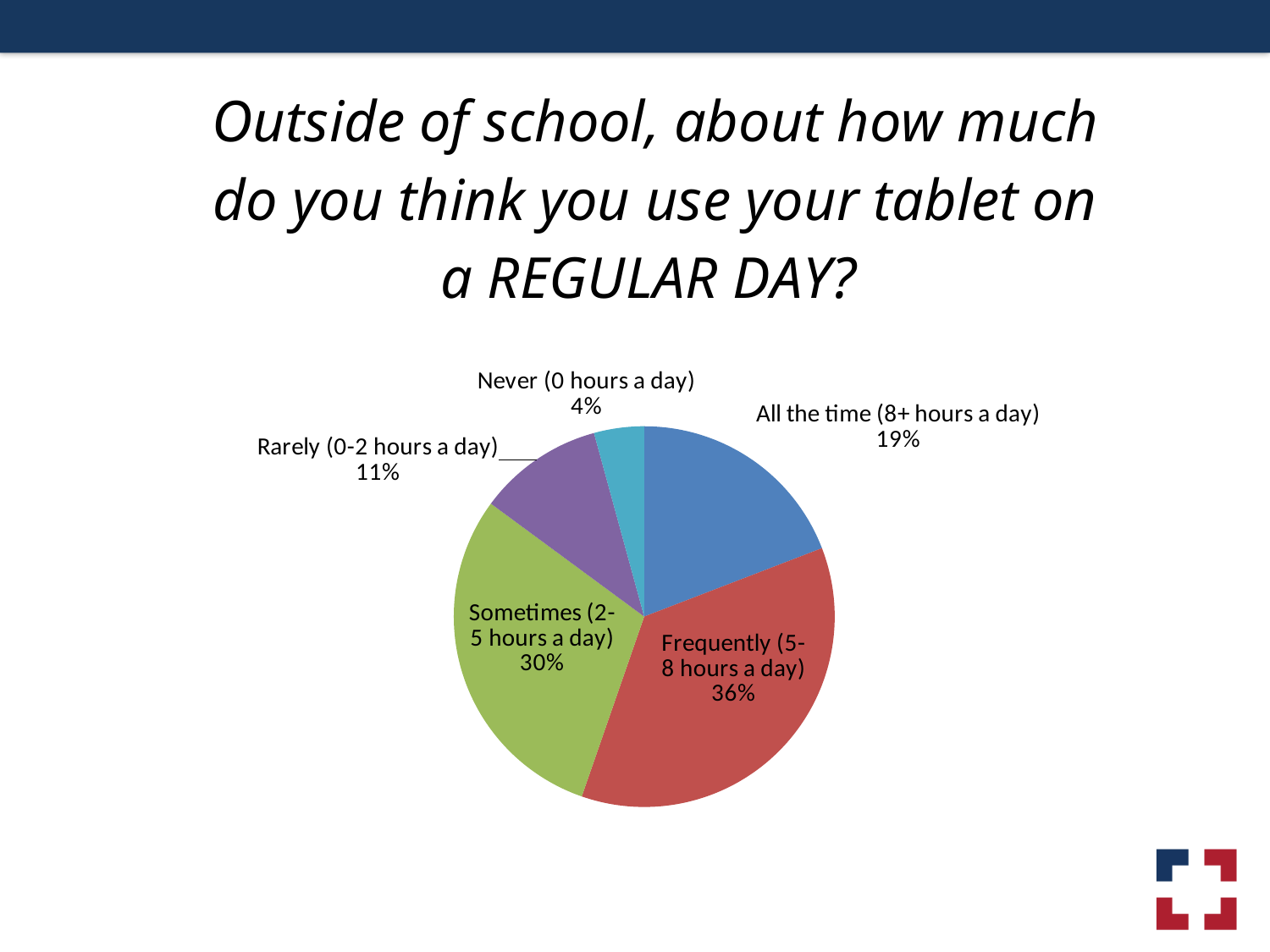
What percentage of respondents chose "Never (0 hours a day)"? 4% What colour is the slice for "Sometimes (2-5 hours a day)"? Green What is the combined share of "Frequently (5-8 hours a day)" and "All the time (8+ hours a day)"? 55% What is the difference in percentage points between "Sometimes (2-5 hours a day)" and "All the time (8+ hours a day)"? 11 What percentage of respondents chose "Frequently (5-8 hours a day)"? 36% Which category has the largest share of the pie? Frequently (5-8 hours a day) Which category has the smallest share of the pie? Never (0 hours a day) What kind of chart is shown on the slide? Pie chart Which is larger: the share for "Sometimes (2-5 hours a day)" or the share for "Rarely (0-2 hours a day)"? Sometimes (2-5 hours a day) What percentage of respondents chose "Rarely (0-2 hours a day)"? 11% How many categories are shown in the pie chart? 5 What percentage of respondents chose "All the time (8+ hours a day)"? 19%